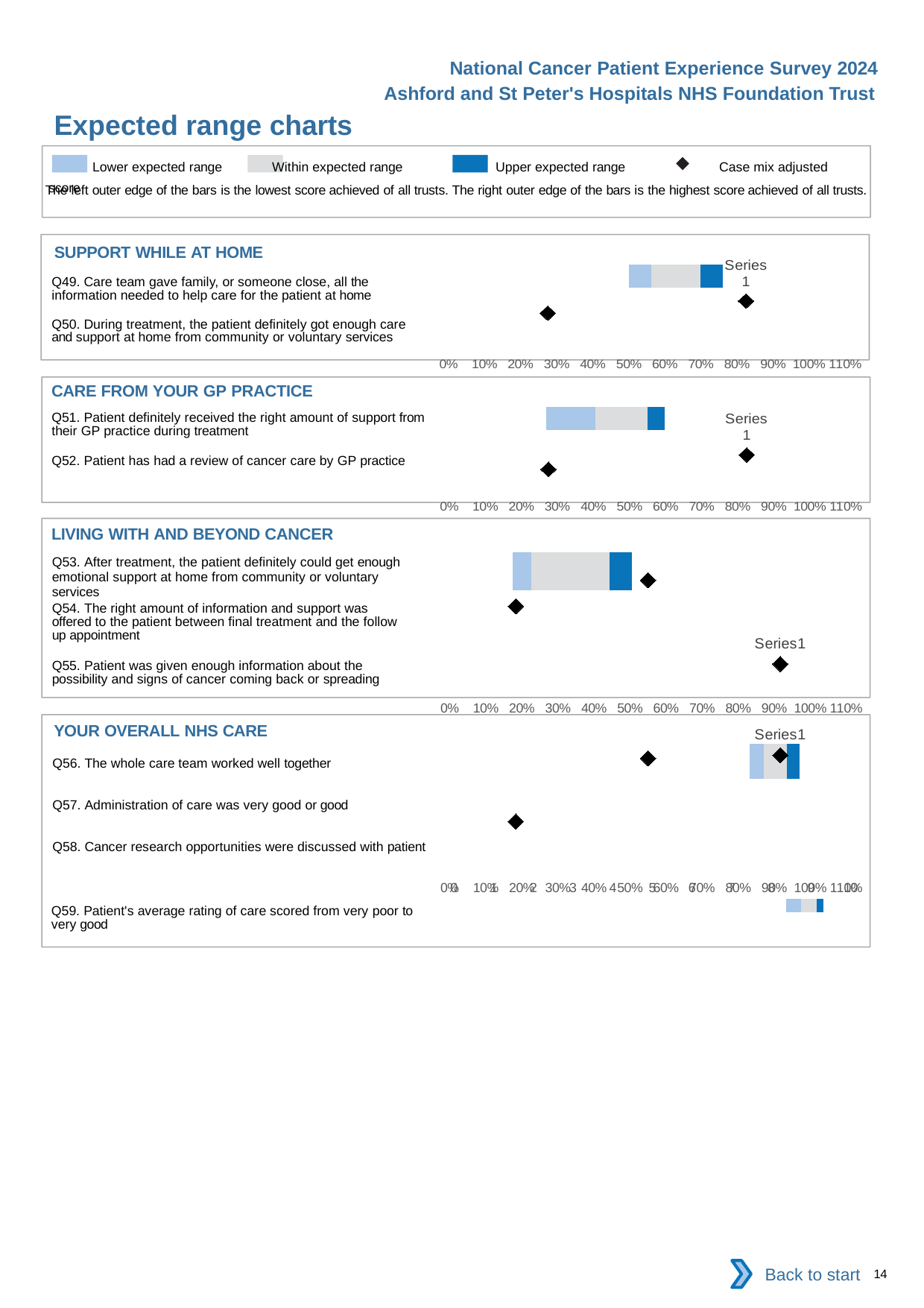
How many questions are listed in the YOUR OVERALL NHS CARE chart? 4 How many questions are listed in the CARE FROM YOUR GP PRACTICE chart? 2 In the LIVING WITH AND BEYOND CANCER chart, is the rightmost case mix adjusted score diamond greater or less than 80%? greater What kind of chart is used in the SUPPORT WHILE AT HOME section? Bar chart In the SUPPORT WHILE AT HOME chart, is the leftmost case mix adjusted score diamond greater or less than 40%? less What is the highest value shown on the x axis of the CARE FROM YOUR GP PRACTICE chart? 110% According to the legend, what does the dark blue colour represent in the charts? Upper expected range In the LIVING WITH AND BEYOND CANCER chart, is the leftmost case mix adjusted score diamond greater or less than 30%? less How many legend entries are shown at the top of the slide for the expected range charts? 4 How many questions are listed in the LIVING WITH AND BEYOND CANCER chart? 3